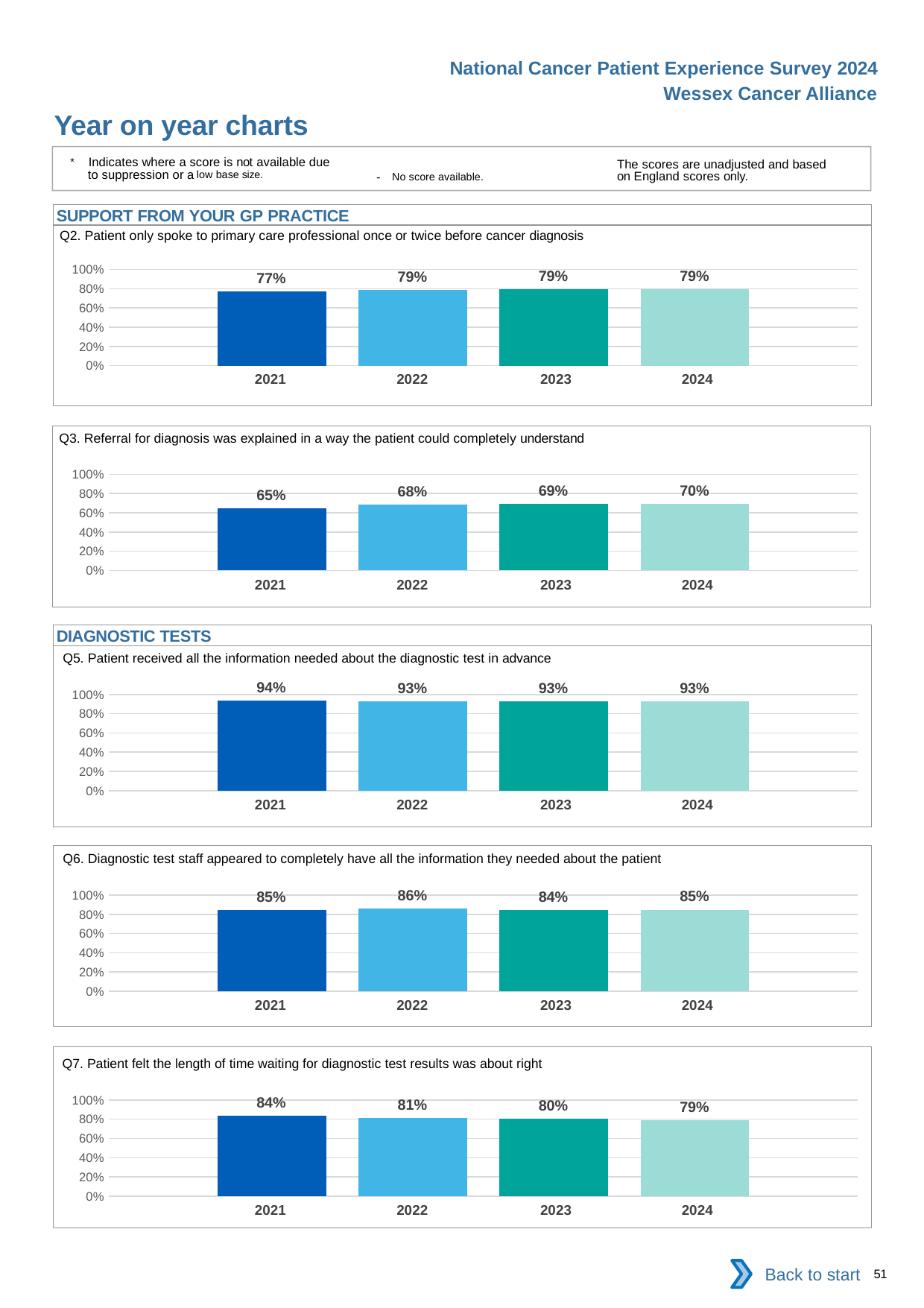
How many years are plotted in the Q2 chart? 4 In the Q3 chart, what is the difference between the 2024 and 2021 values? 5 percentage points In the Q7 chart, which is larger, the value for 2021 or the value for 2024? 2021 In the Q6 chart (diagnostic test staff appeared to completely have all the information they needed about the patient), what is the value for 2022? 86% In the Q7 chart (patient felt the length of time waiting for diagnostic test results was about right), do the values rise or fall from 2021 to 2024? fall In the Q5 chart, what is the value for 2023? 93% In the Q6 chart, what is the difference between the 2022 and 2023 values? 2 percentage points What type of chart is used for Q7? bar chart In the Q2 chart (patient only spoke to primary care professional once or twice before cancer diagnosis), what is the value for 2021? 77% In the Q3 chart, which year has the lowest value? 2021 In the Q3 chart (referral for diagnosis was explained in a way the patient could completely understand), what is the value for 2024? 70% In the Q5 chart (patient received all the information needed about the diagnostic test in advance), which year has the highest value? 2021